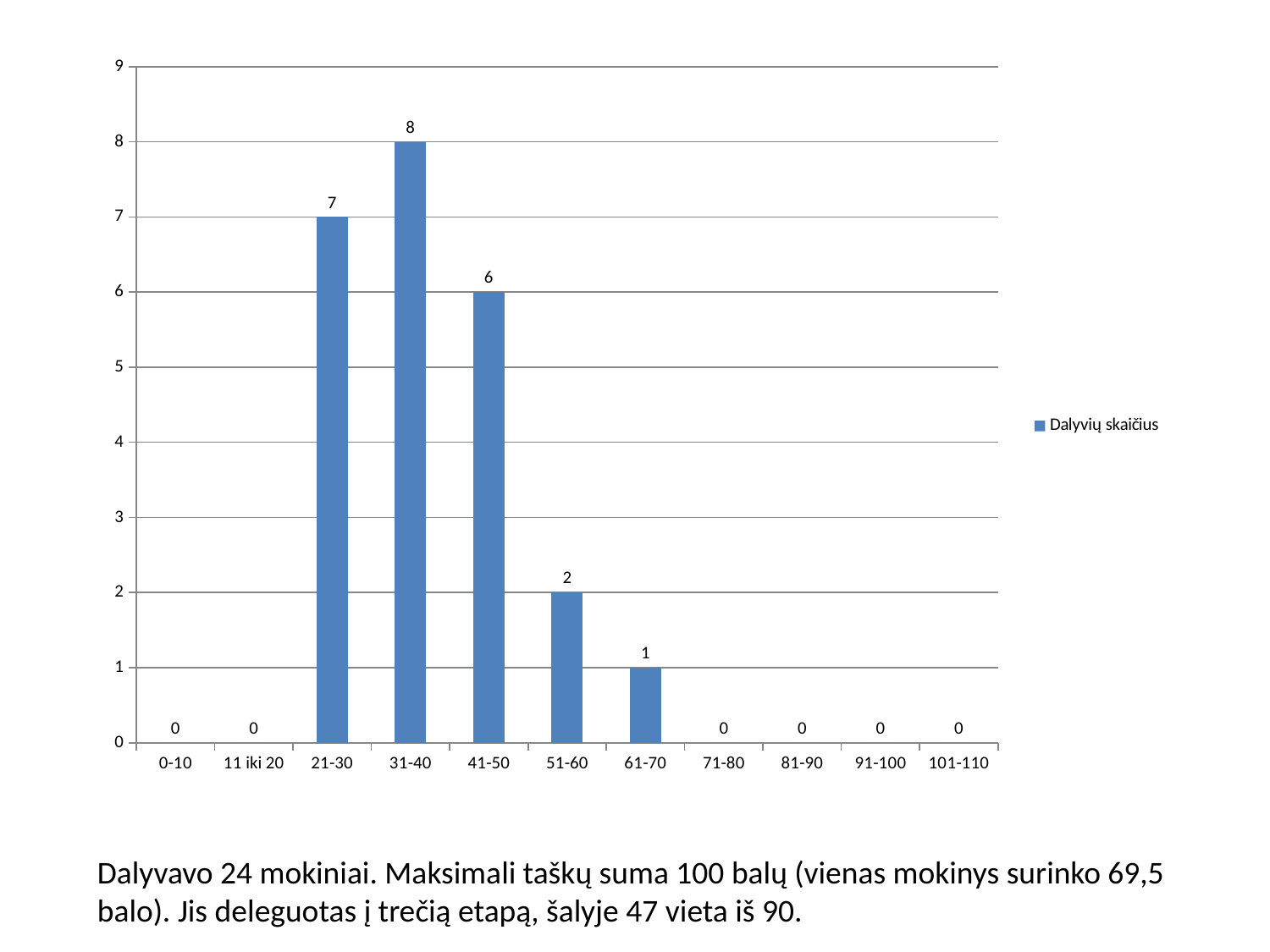
What is the difference between the values for 31-40 and 41-50? 2 What kind of chart is shown on the slide? bar chart Do the values rise or fall from 31-40 to 61-70? fall What is the name of the series in the legend? Dalyvių skaičius What is the value for the 31-40 category? 8 What is the value for the 21-30 category? 7 What is the value for the 61-70 category? 1 Which category has the highest value? 31-40 How many series does the legend list? 1 Which is larger, the value for 21-30 or the value for 51-60? 21-30 How many categories are shown on the x axis? 11 How many categories have a value of 0? 6